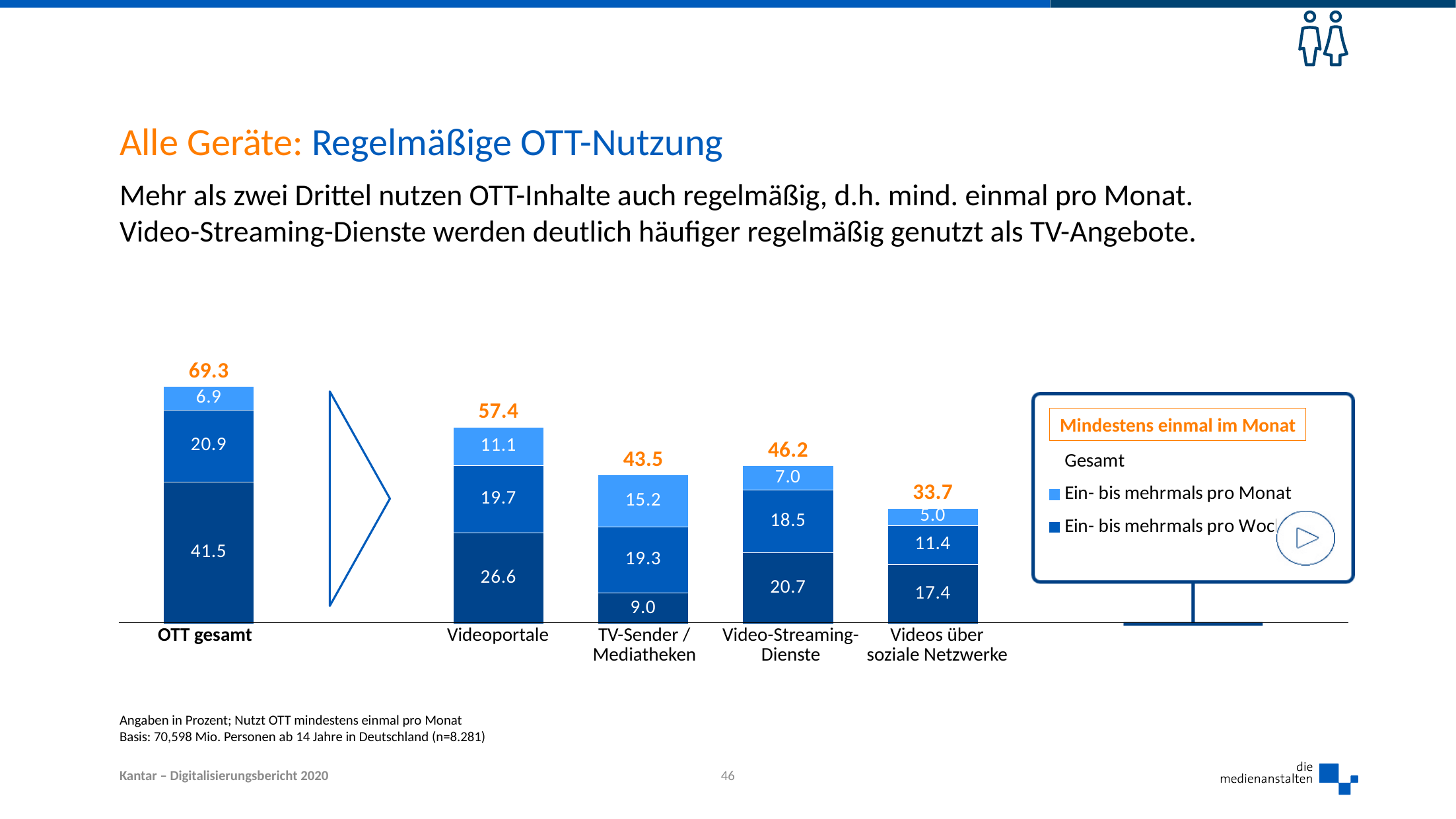
What is the difference between the total values of Video-Streaming-Dienste and TV-Sender / Mediatheken? 2.7 What is the total value shown above the Videos über soziale Netzwerke bar? 33.7 What kind of chart is shown on the slide? Stacked bar chart Which has the larger total value, Video-Streaming-Dienste or TV-Sender / Mediatheken? Video-Streaming-Dienste What is the value of the 'Ein- bis mehrmals pro Monat' segment for Videoportale? 11.1 What is the difference between the total values of OTT gesamt and Videos über soziale Netzwerke? 35.6 Which category has the lowest total value? Videos über soziale Netzwerke Which category has the highest total value? OTT gesamt What is the total value shown above the Videoportale bar? 57.4 What is the value of the bottom segment of the Videoportale bar? 26.6 What is the total value shown above the OTT gesamt bar? 69.3 How many categories are shown on the x axis of the chart? 5